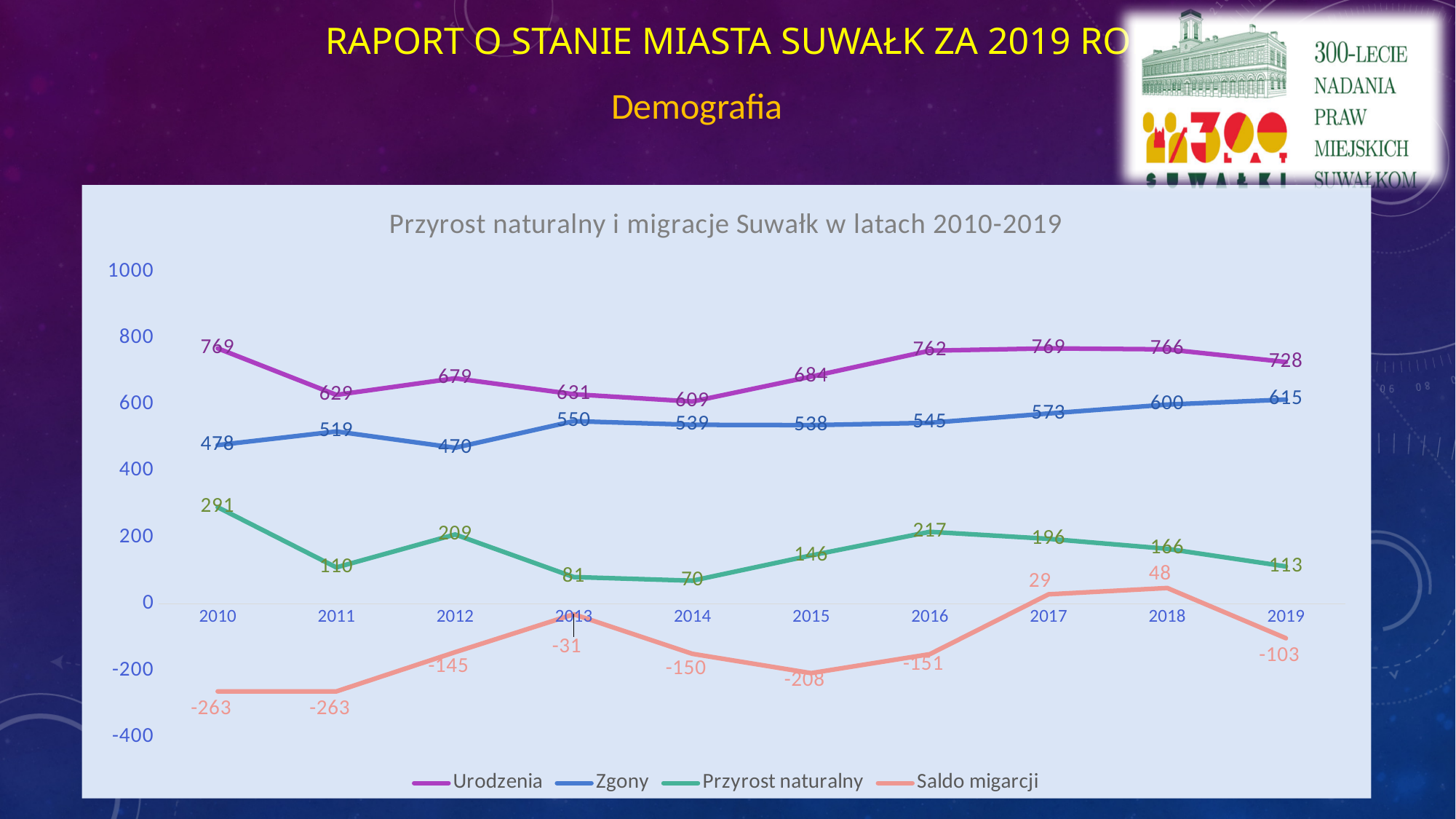
What is the value of Urodzenia in 2014? 609 Which is larger in 2012: Przyrost naturalny or Zgony? Zgony How many years are plotted on the x axis? 10 What is the difference between Urodzenia and Zgony in 2019? 113 What type of chart is shown on the slide? line chart In which year is Przyrost naturalny lowest? 2014 In which year is Saldo migarcji highest? 2018 How many series does the legend list? 4 In which year is Zgony highest? 2019 What is the value of Zgony in 2018? 600 What is the title of the chart? Przyrost naturalny i migracje Suwałk w latach 2010-2019 What is the value of Saldo migarcji in 2015? -208